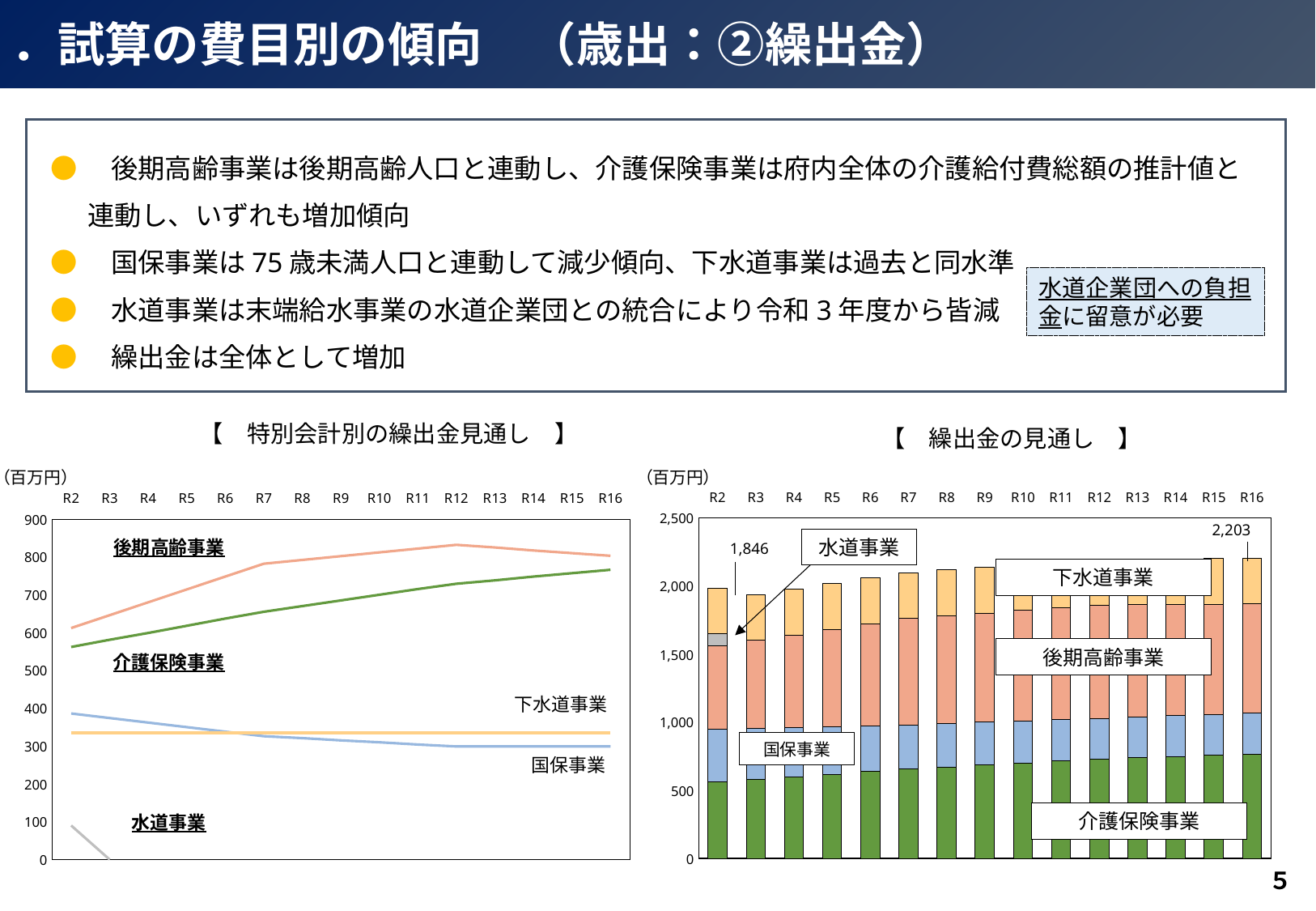
In the left chart 特別会計別の繰出金見通し, which series has the highest value at R7? 後期高齢事業 How many years (categories) are shown on the x axis of the left chart 特別会計別の繰出金見通し? 15 How many series are plotted in the left chart 特別会計別の繰出金見通し? 5 What kind of chart is the right chart titled 繰出金の見通し? bar chart In the right chart 繰出金の見通し, what is the total value of the stacked bar for R2? 1,846 In the right chart 繰出金の見通し, which is larger, the total for R2 or the total for R16? R16 In the right chart 繰出金の見通し, what is the total value of the stacked bar for R16? 2,203 In the left chart 特別会計別の繰出金見通し, is the value for 後期高齢事業 at R2 greater or less than 700? less In the left chart 特別会計別の繰出金見通し, does the 介護保険事業 line rise or fall from R2 to R16? rise In the right chart 繰出金の見通し, what is the difference between the R16 total and the R2 total? 357 What kind of chart is the left chart titled 特別会計別の繰出金見通し? line chart In the left chart 特別会計別の繰出金見通し, does the 国保事業 line rise or fall from R2 to R16? fall